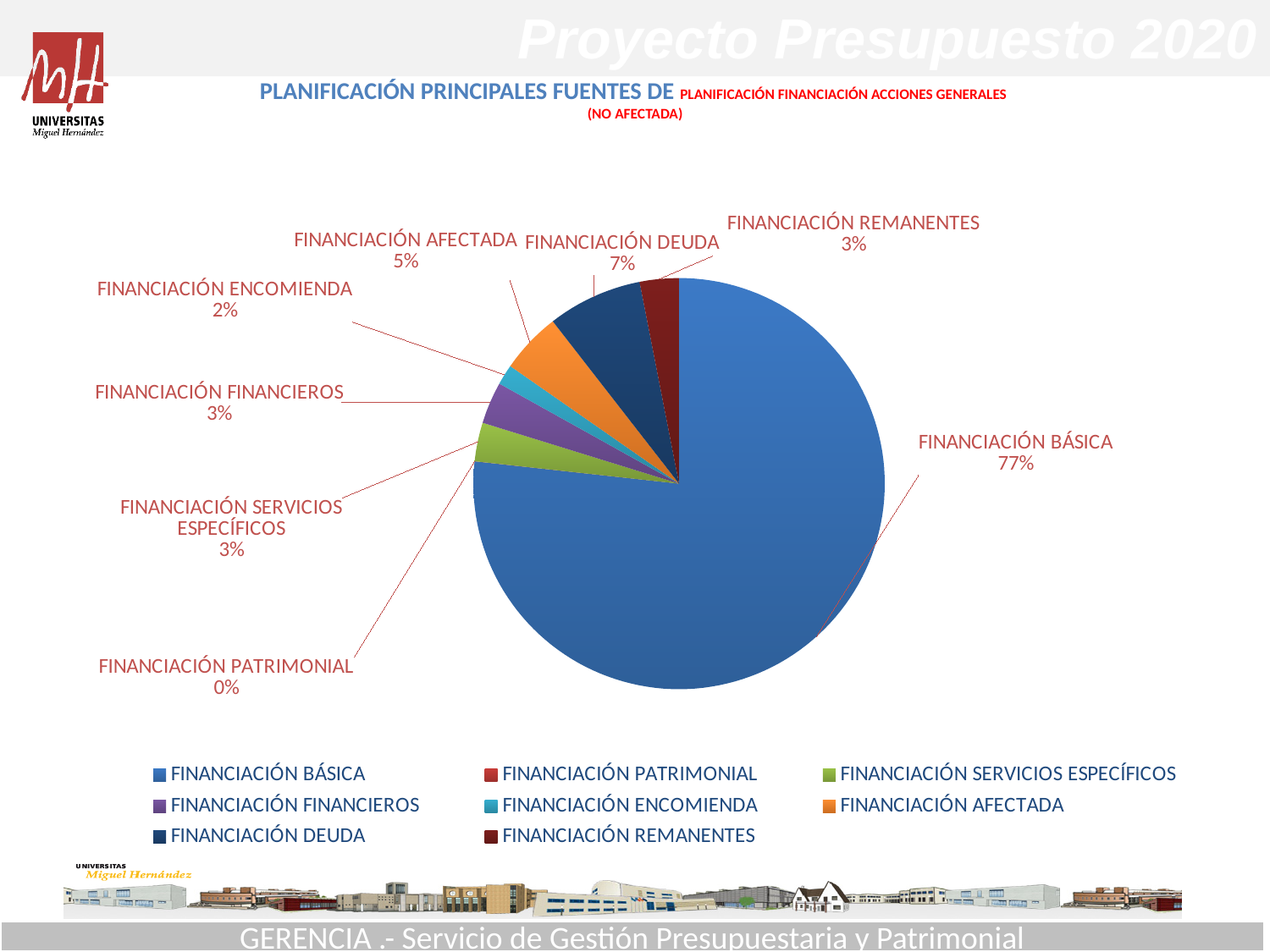
What is the difference between the values for FINANCIACIÓN BÁSICA and FINANCIACIÓN DEUDA? 70% What is the value shown for FINANCIACIÓN AFECTADA? 5% Which category has the largest slice of the pie? FINANCIACIÓN BÁSICA Which category has the smallest slice of the pie? FINANCIACIÓN PATRIMONIAL What share of the pie does FINANCIACIÓN BÁSICA represent? 77% What is the value shown for FINANCIACIÓN ENCOMIENDA? 2% What kind of chart is shown on the slide? Pie chart What colour is the FINANCIACIÓN BÁSICA slice? Blue What is the value shown for FINANCIACIÓN PATRIMONIAL? 0% How many categories does the legend list? 8 Which is larger, FINANCIACIÓN DEUDA or FINANCIACIÓN AFECTADA? FINANCIACIÓN DEUDA What is the value shown for FINANCIACIÓN DEUDA? 7%